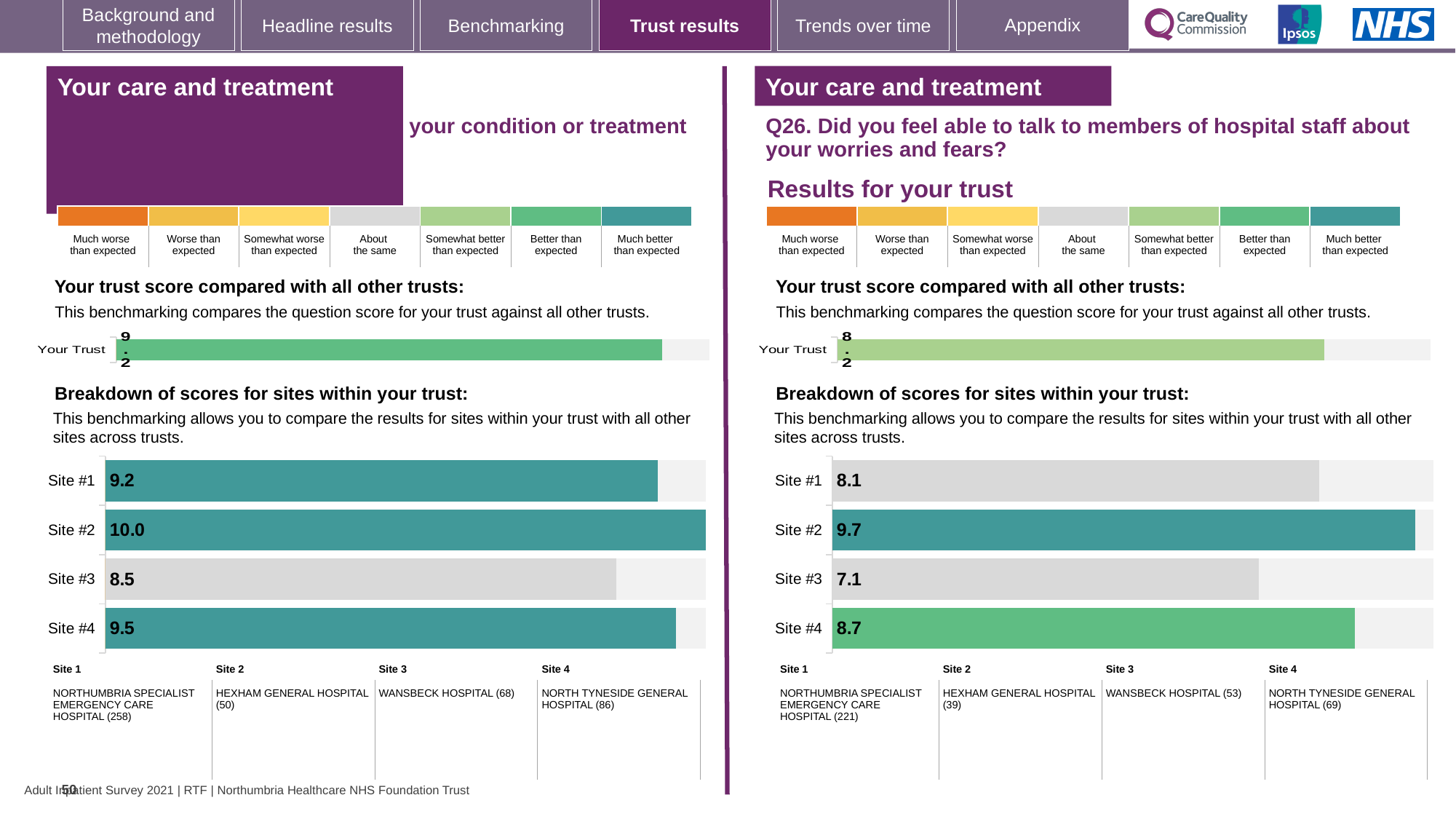
On the right-hand chart (Q26), what is the score for Site #2 in the breakdown of scores for sites? 9.7 On the left-hand chart, what is the 'Your Trust' score shown in the trust benchmarking bar? 9.2 On the right-hand chart (Q26), which has the higher score, Site #1 or Site #4? Site #4 On the right-hand chart (Q26), which site has the lowest score in the breakdown of sites? Site #3 What type of chart is used for the breakdown of scores for sites on the right-hand side? Bar chart On the right-hand chart (Q26), which site's bar is coloured grey, indicating 'About the same', with a score of 8.1? Site #1 On the left-hand chart, what is the difference between the scores for Site #2 and Site #1? 0.8 On the right-hand chart (Q26), what is the 'Your Trust' score shown in the trust benchmarking bar? 8.2 On the right-hand chart (Q26), what is the difference between the scores for Site #2 and Site #3? 2.6 How many sites are shown in the breakdown of scores on the left-hand chart? 4 On the left-hand chart, which site has the highest score in the breakdown of sites? Site #2 On the left-hand chart, what is the score for Site #3 in the breakdown of scores for sites? 8.5